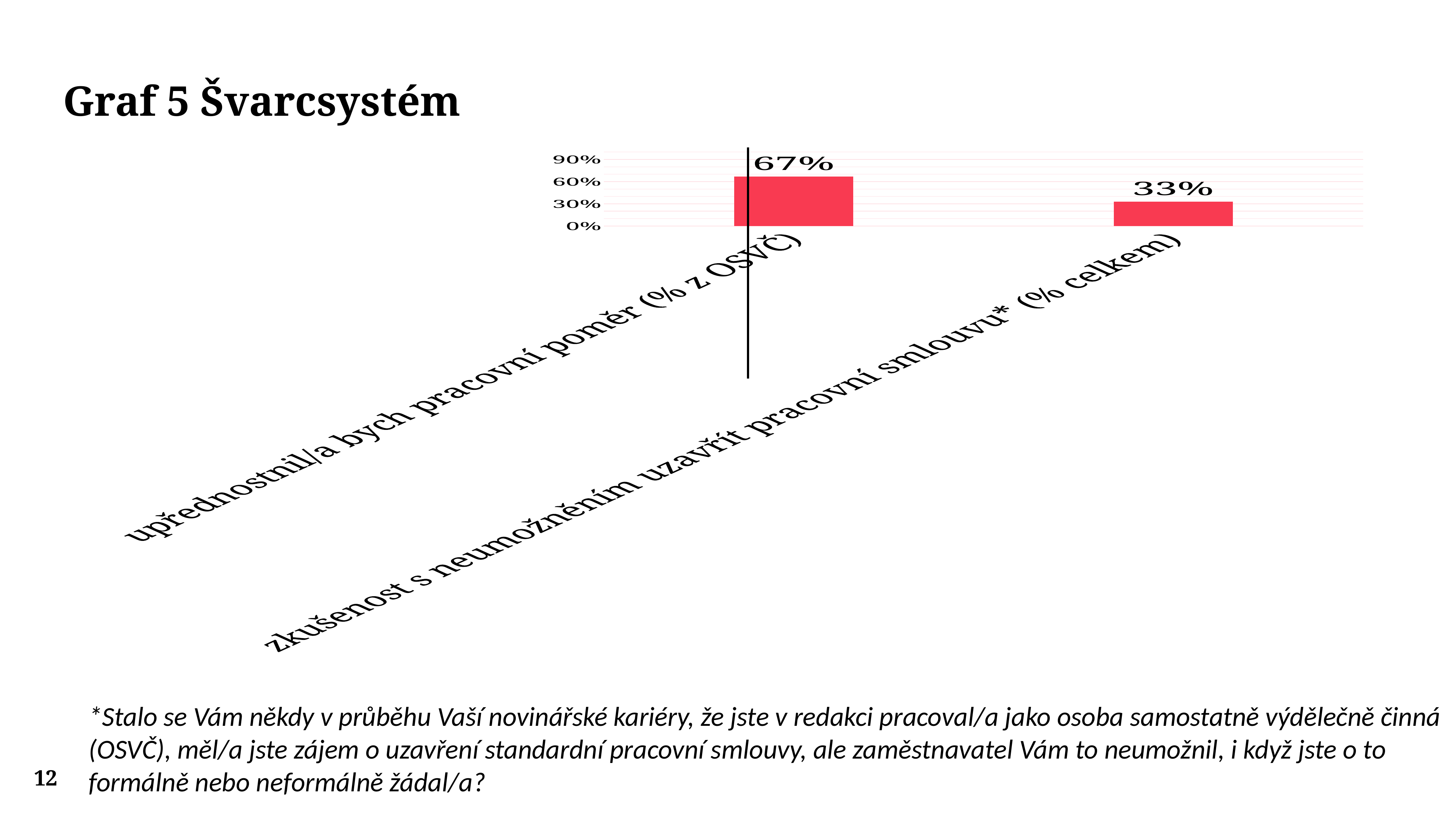
How many categories are shown in the chart? 2 What is the title of the slide? Graf 5 Švarcsystém Is the value for 'upřednostnil/a bych pracovní poměr (% z OSVČ)' greater or less than 60%? greater What is the value for 'upřednostnil/a bych pracovní poměr (% z OSVČ)'? 67% Do the values rise or fall from left to right along the x axis? fall What is the difference between the values for 'upřednostnil/a bych pracovní poměr (% z OSVČ)' and 'zkušenost s neumožněním uzavřít pracovní smlouvu* (% celkem)'? 34% What is the value for 'zkušenost s neumožněním uzavřít pracovní smlouvu* (% celkem)'? 33% What kind of chart is shown on the slide? bar chart Which category has the lowest value? zkušenost s neumožněním uzavřít pracovní smlouvu* (% celkem) Which category has the highest value? upřednostnil/a bych pracovní poměr (% z OSVČ) Is the value for 'zkušenost s neumožněním uzavřít pracovní smlouvu* (% celkem)' greater or less than 60%? less Which is larger: the value for 'upřednostnil/a bych pracovní poměr (% z OSVČ)' or for 'zkušenost s neumožněním uzavřít pracovní smlouvu* (% celkem)'? upřednostnil/a bych pracovní poměr (% z OSVČ)